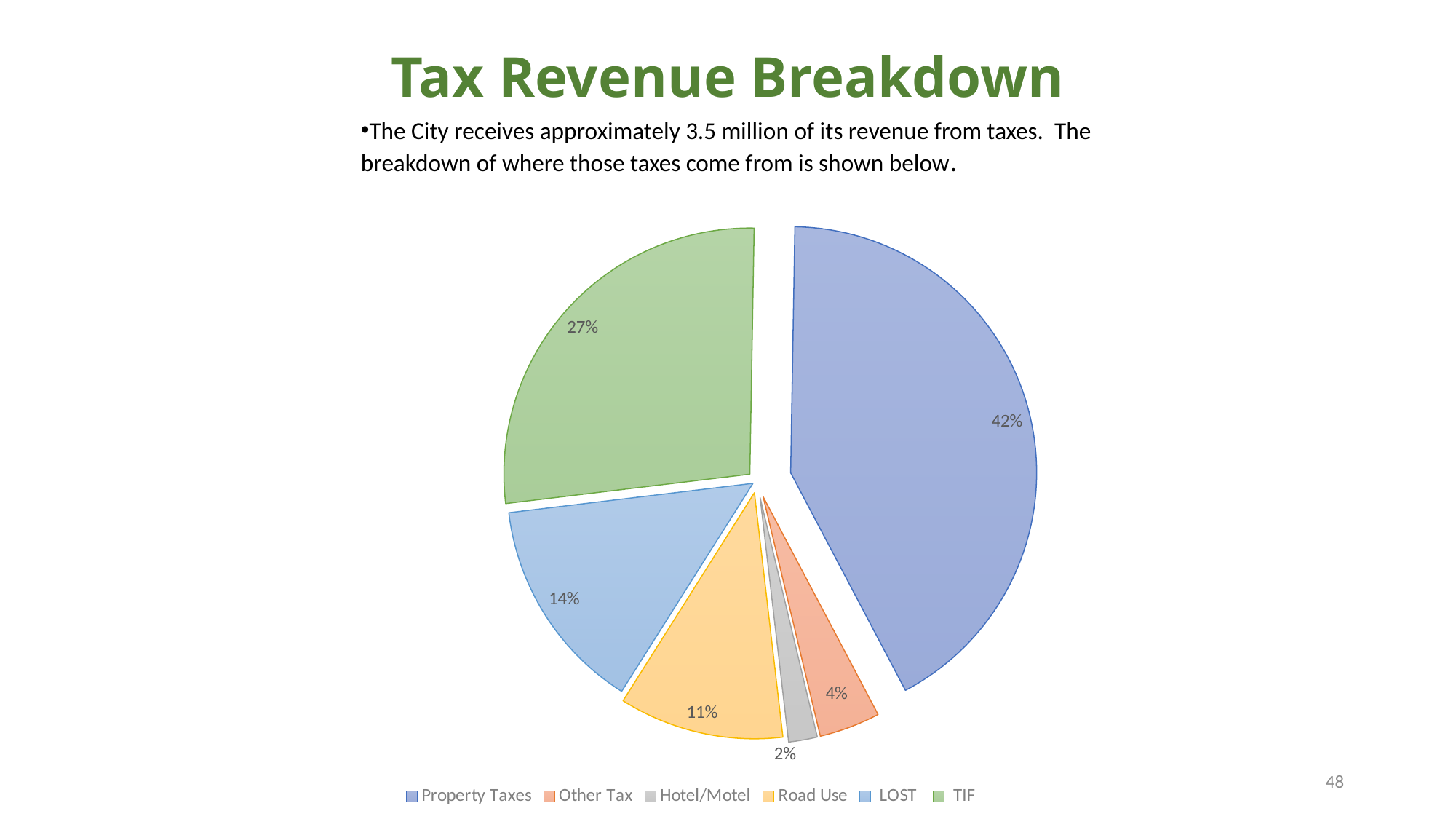
What kind of chart is shown on the slide? Pie chart How many categories does the pie chart show? 6 What share of tax revenue comes from Property Taxes? 42% What share of tax revenue comes from LOST? 14% Which category has the smallest share of tax revenue? Hotel/Motel What share of tax revenue comes from TIF? 27% What share of tax revenue comes from Hotel/Motel? 2% What share of tax revenue comes from Road Use? 11% Which category has the largest share of tax revenue? Property Taxes Which is larger, the share for LOST or the share for Road Use? LOST How many percentage points larger is the Property Taxes share than the TIF share? 15 What colour is the Other Tax slice? Orange